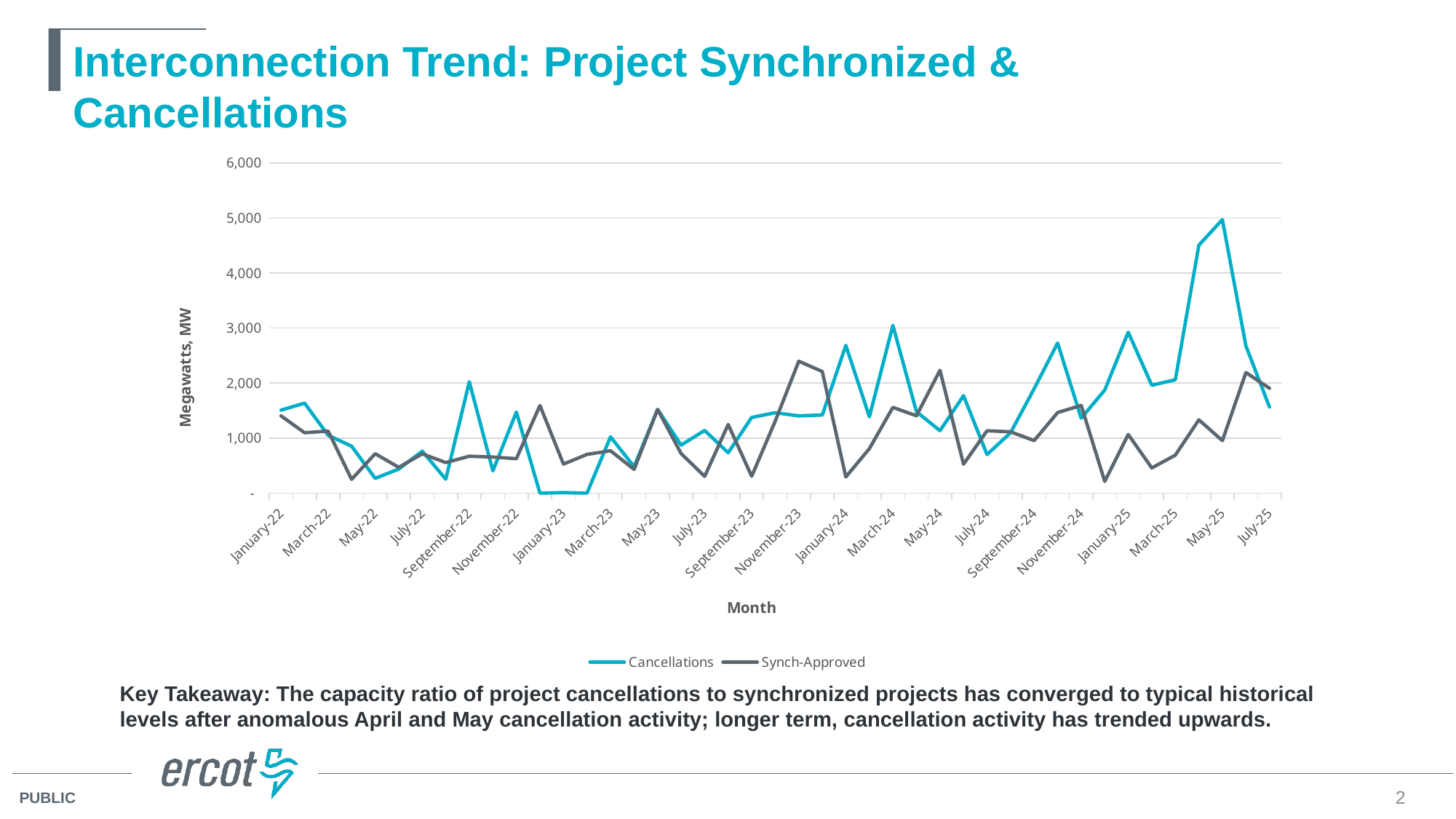
Is the Cancellations value for January-23 greater or less than 1,000? less What are the two series named in the legend? Cancellations and Synch-Approved In which month does the Cancellations series reach its highest value? May-25 What is the label on the vertical axis? Megawatts, MW How many series does the legend list? 2 What kind of chart is shown on the slide? Line chart Is the Cancellations value for May-25 greater or less than 4,000? greater Is the Synch-Approved value for November-23 greater or less than 2,000? greater In May-25, which series has the larger value, Cancellations or Synch-Approved? Cancellations In November-23, which series has the larger value, Cancellations or Synch-Approved? Synch-Approved